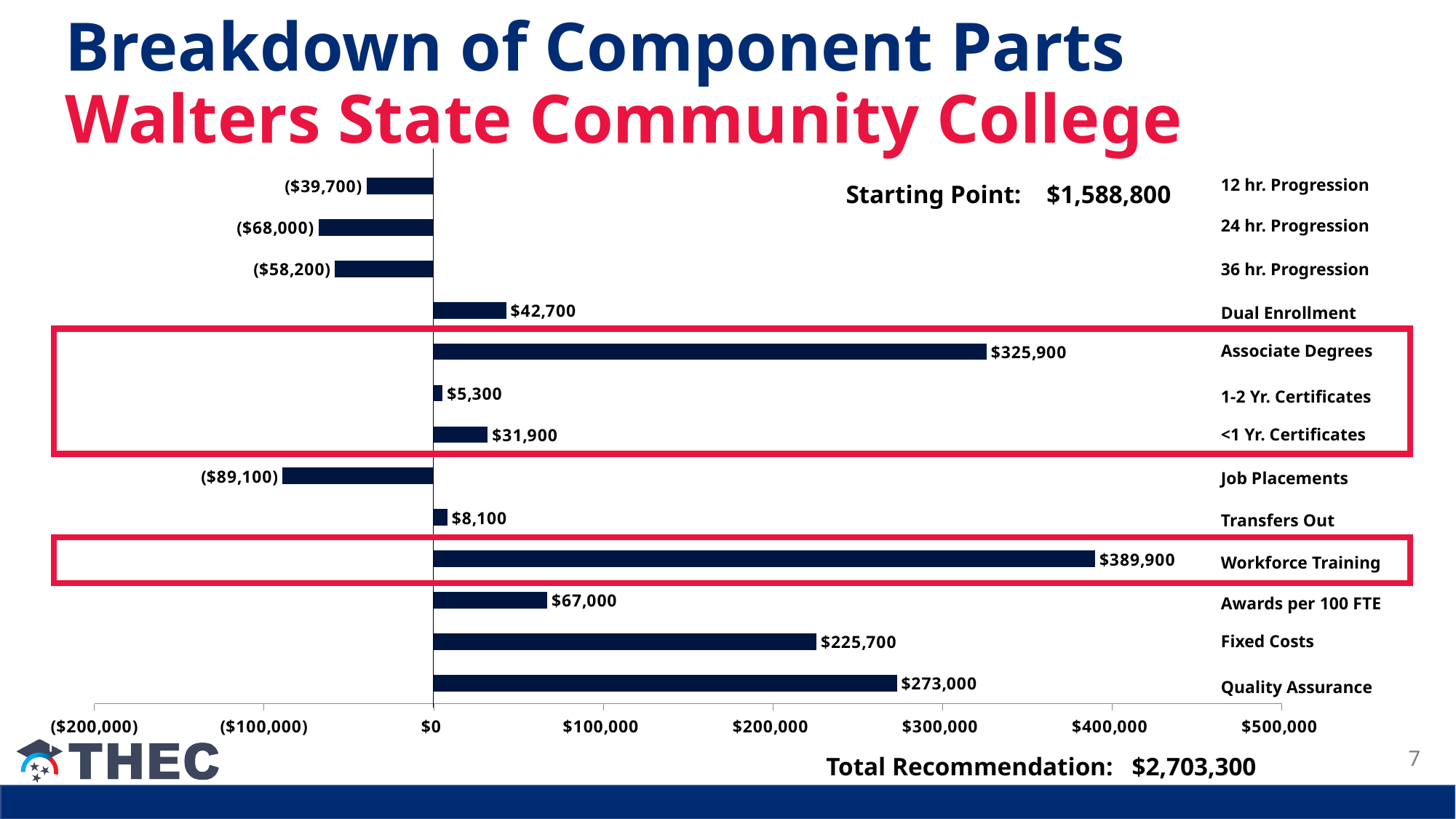
What is the value for Job Placements? ($89,100) What kind of chart is shown on the slide? Bar chart What is the Starting Point shown on the slide? $1,588,800 What is the Total Recommendation shown on the slide? $2,703,300 What is the value for Fixed Costs? $225,700 What is the value for Associate Degrees? $325,900 Which category has the lowest (most negative) value? Job Placements What is the value for Workforce Training? $389,900 What is the difference between the values for Workforce Training and Associate Degrees? $64,000 Which is larger, the value for Quality Assurance or the value for Fixed Costs? Quality Assurance Which category has the highest value? Workforce Training How many categories are shown in the chart? 13